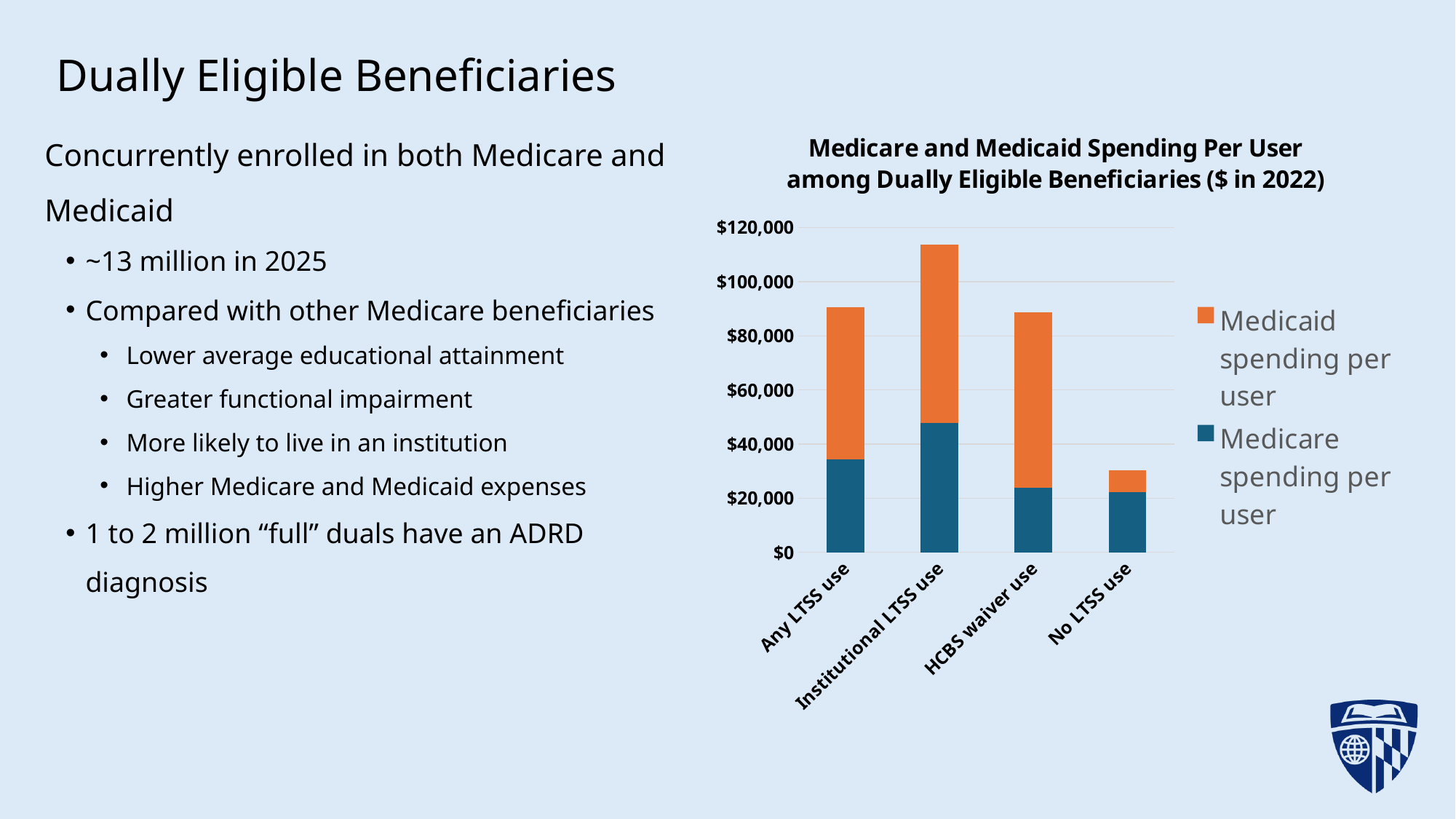
Which category has the lowest total spending per user? No LTSS use Which colour represents Medicaid spending per user in the chart? Orange Is the Medicare spending per user for Any LTSS use greater or less than $40,000? less Which category has the highest total spending per user? Institutional LTSS use Which category has the highest Medicare spending per user? Institutional LTSS use How many categories are shown on the x axis of the chart? 4 Is the total spending per user for Institutional LTSS use greater or less than $100,000? greater How many series does the chart's legend list? 2 Which is larger: the total spending per user for Institutional LTSS use or for Any LTSS use? Institutional LTSS use Which category has the lowest Medicaid spending per user? No LTSS use What kind of chart is shown on the slide? Stacked bar chart Is the total spending per user for No LTSS use greater or less than $40,000? less